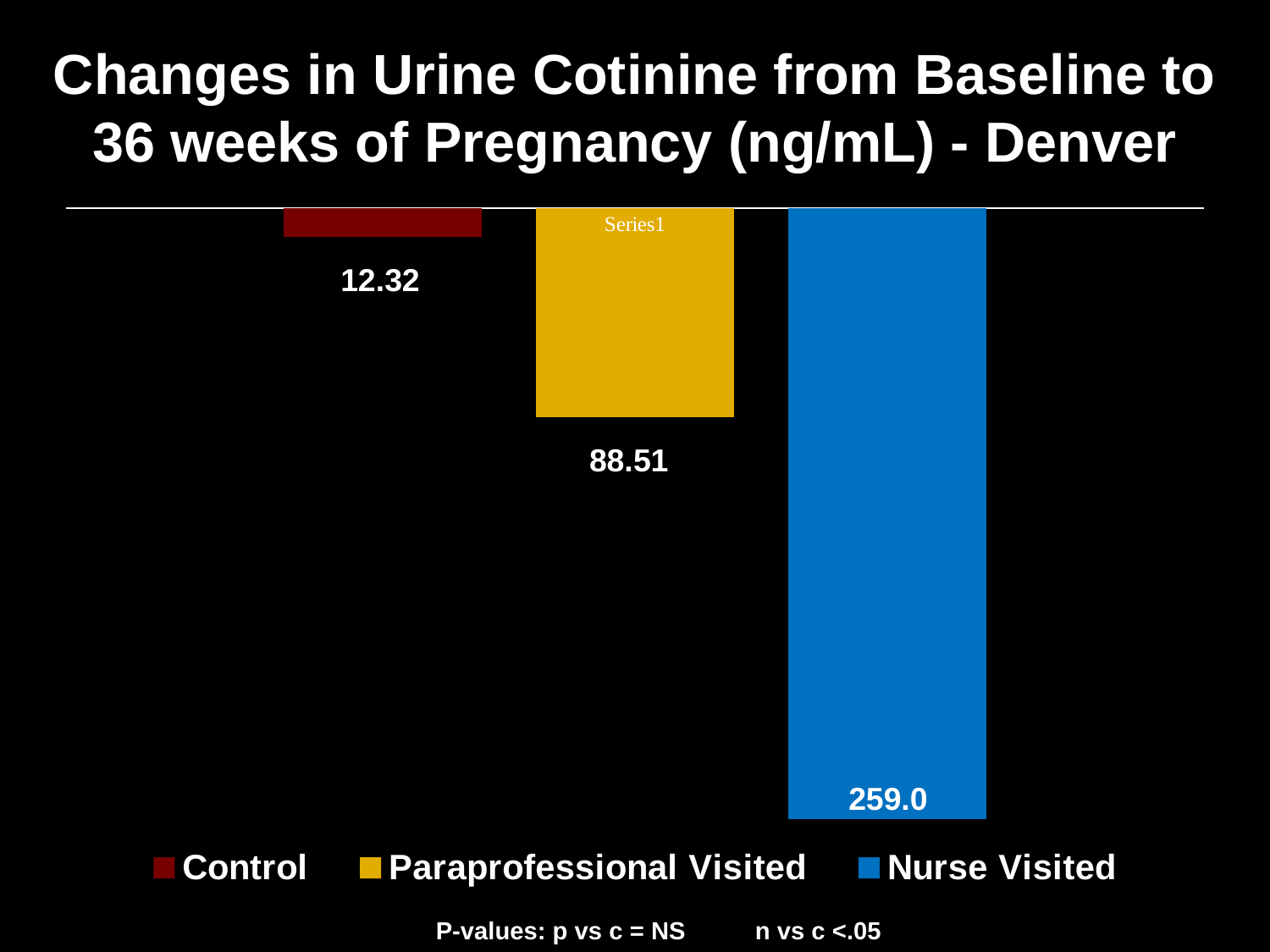
What is the value shown for the Nurse Visited group? 259.0 What colour is the bar for the Nurse Visited group? Blue What kind of chart is shown on the slide? Bar chart How many bars are plotted in the chart? 3 What is the difference between the Nurse Visited value and the Control value? 246.68 How many entries does the legend list? 3 Which group has the smallest change in urine cotinine? Control Which is larger, the value for Paraprofessional Visited or the value for Nurse Visited? Nurse Visited What is the value shown for the Paraprofessional Visited group? 88.51 Which group has the largest change in urine cotinine? Nurse Visited What is the difference between the Paraprofessional Visited value and the Control value? 76.19 What is the value shown for the Control group? 12.32